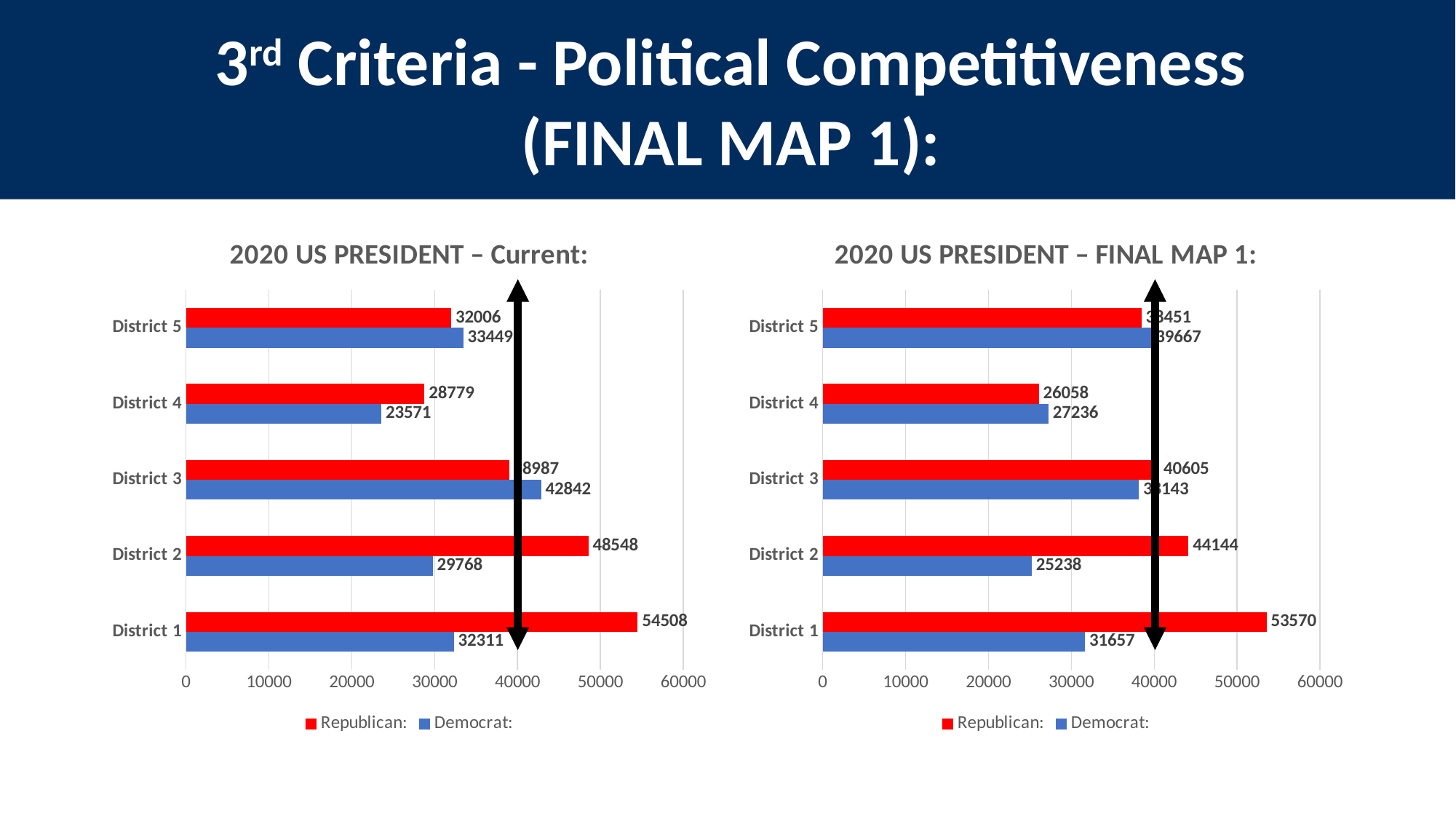
In the '2020 US PRESIDENT – Current:' chart, which district has the lowest Democrat value? District 4 In the '2020 US PRESIDENT – Current:' chart, what is the difference between the Republican and Democrat values for District 2? 18780 In the '2020 US PRESIDENT – Current:' chart, what is the Republican value for District 1? 54508 What type of chart is the '2020 US PRESIDENT – FINAL MAP 1:' chart? Bar chart How many districts are shown in the '2020 US PRESIDENT – Current:' chart? 5 In the '2020 US PRESIDENT – Current:' chart, which district has the highest Republican value? District 1 In the '2020 US PRESIDENT – FINAL MAP 1:' chart, what is the Democrat value for District 4? 27236 In the '2020 US PRESIDENT – Current:' chart, what is the Democrat value for District 3? 42842 In the '2020 US PRESIDENT – FINAL MAP 1:' chart, is the Republican value for District 4 greater or less than 30000? less In the '2020 US PRESIDENT – FINAL MAP 1:' chart, which district has the lowest Democrat value? District 2 In the '2020 US PRESIDENT – FINAL MAP 1:' chart, what is the difference between the Republican and Democrat values for District 1? 21913 In the '2020 US PRESIDENT – FINAL MAP 1:' chart, what is the Republican value for District 2? 44144